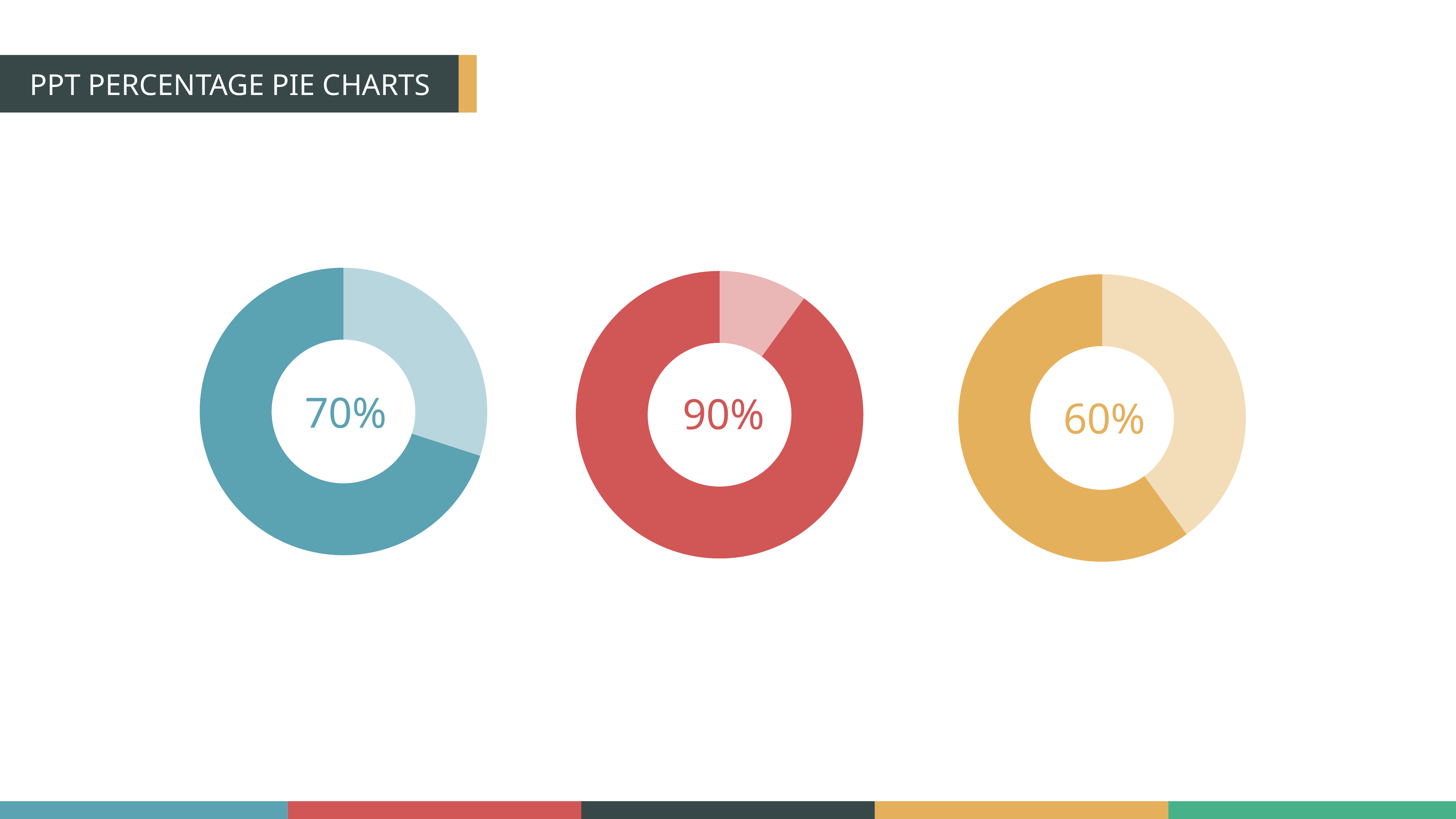
Which of the three donut charts shows the highest percentage? The middle (red) chart, 90% What percentage is shown in the centre of the right (yellow) donut chart? 60% How many donut charts are shown on the slide? 3 What percentage is shown in the centre of the left (blue) donut chart? 70% Which of the three donut charts shows the lowest percentage? The right (yellow) chart, 60% What percentage is shown in the centre of the middle (red) donut chart? 90% In the left (blue) donut chart, what share of the ring is filled by the darker blue segment? 70% What is the difference between the percentage in the middle (red) chart and the percentage in the right (yellow) chart? 30% What kind of chart is used on this slide? Pie (donut) chart Which is larger, the percentage in the left (blue) chart or the percentage in the right (yellow) chart? The left (blue) chart, 70% What is the title of the slide? PPT PERCENTAGE PIE CHARTS What is the difference between the percentage in the left (blue) chart and the percentage in the right (yellow) chart? 10%